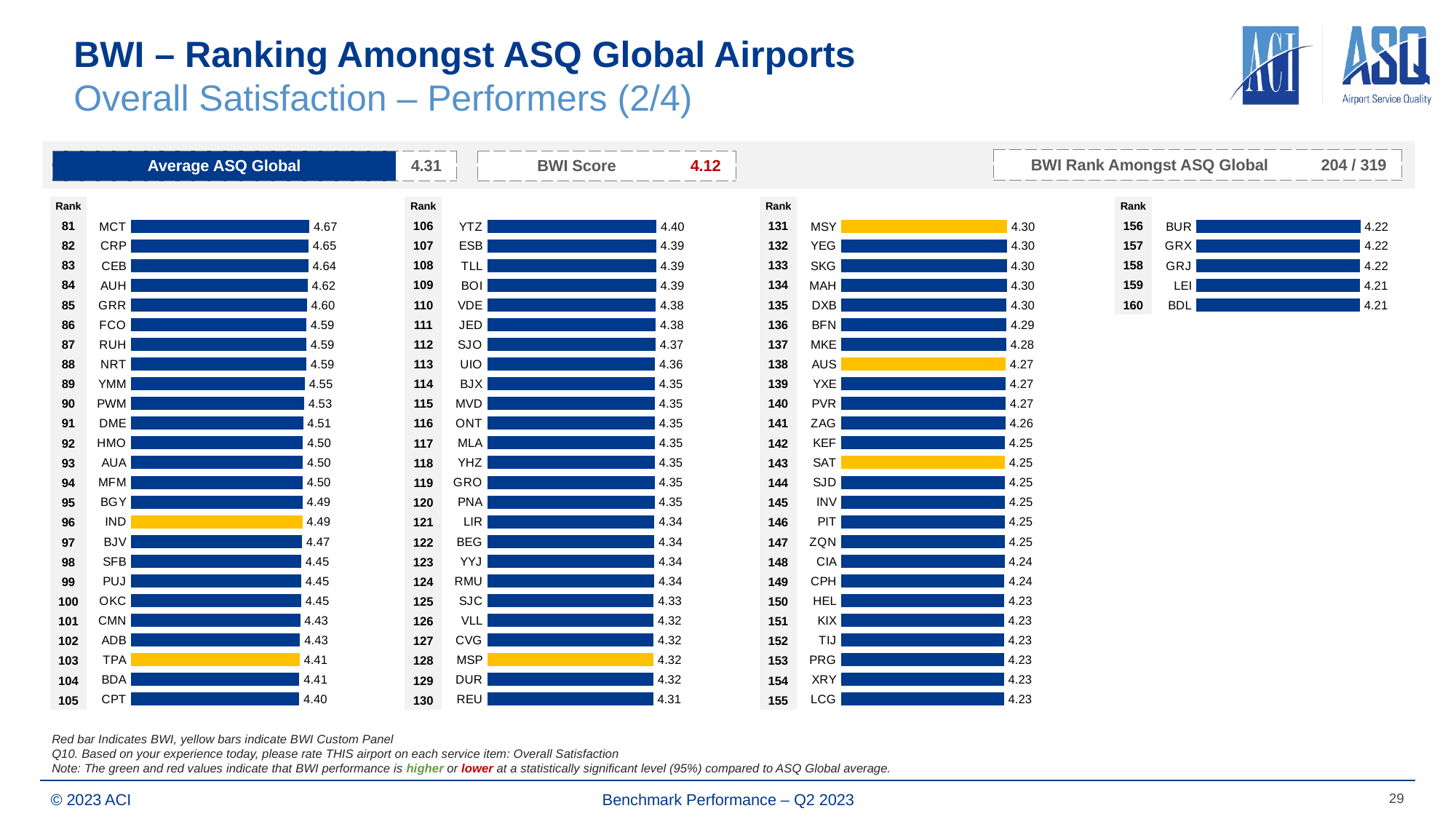
In the third chart from the left (ranks 131–155), what is the value for MKE? 4.28 In the leftmost chart (ranks 81–105), which airport has the highest value? MCT In the second chart from the left (ranks 106–130), which airport has the lowest value? REU What kind of chart is used to show the airport scores on this slide? Bar chart In the second chart from the left (ranks 106–130), what is the value for SJO? 4.37 In the leftmost chart (ranks 81–105), what is the value for MCT? 4.67 In the leftmost chart (ranks 81–105), what is the difference between the values for MCT and CPT? 0.27 In the leftmost chart (ranks 81–105), which airports are shown with yellow bars? IND and TPA How many airports are plotted in the rightmost chart (ranks 156–160)? 5 In the rightmost chart (ranks 156–160), what is the value for LEI? 4.21 How many airports are plotted in the leftmost chart (ranks 81–105)? 25 In the third chart from the left (ranks 131–155), which is larger, the value for MSY or the value for LCG? MSY